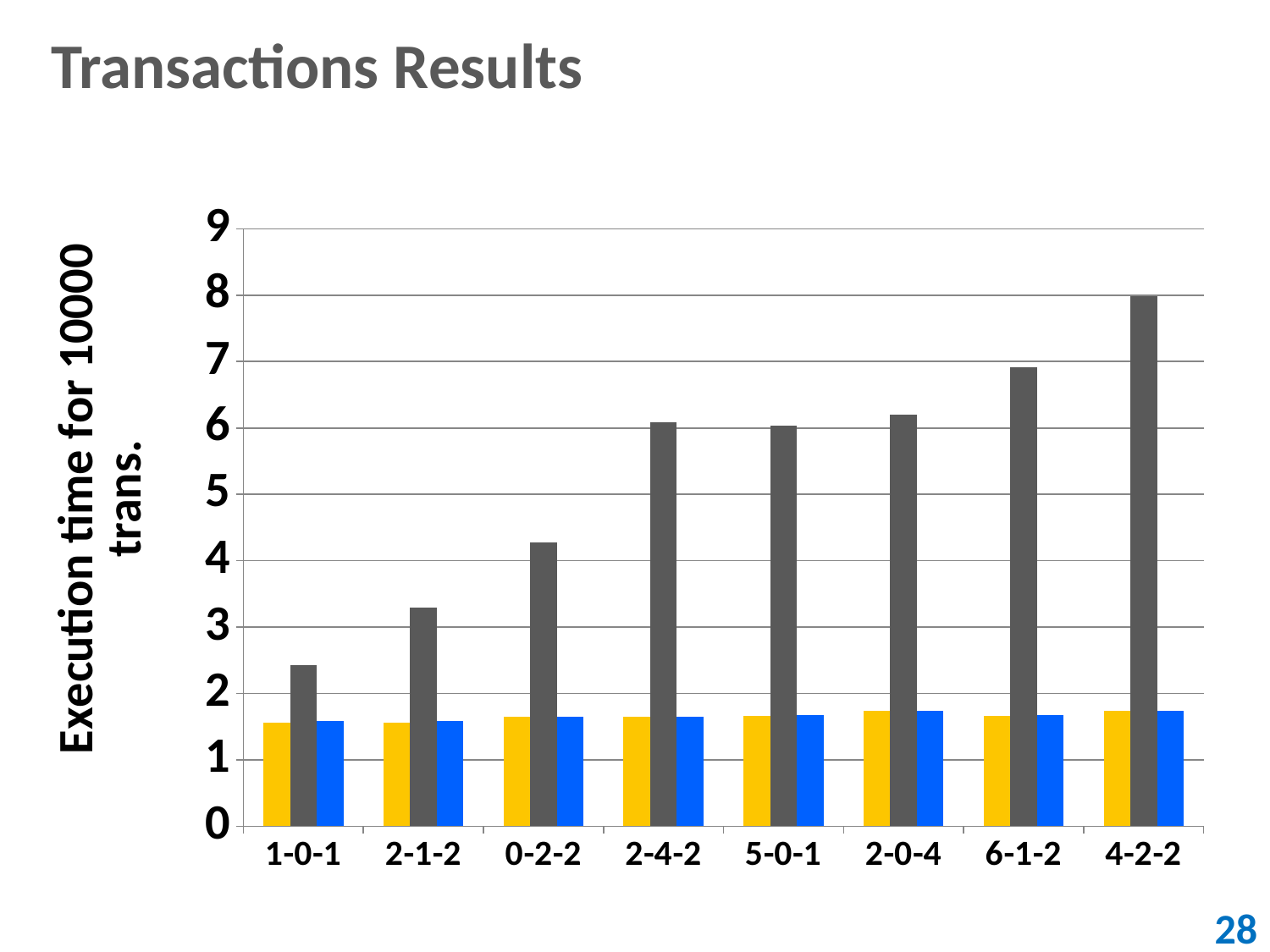
Is the dark gray bar for 1-0-1 greater or less than 3? less Is the dark gray bar for 4-2-2 greater or less than 7? greater Is the dark gray bar for 6-1-2 greater or less than 6? greater How many categories are shown along the x axis? 8 What kind of chart is shown on the slide? bar chart Which category has the tallest dark gray bar? 4-2-2 Which category has the shortest dark gray bar? 1-0-1 Which has the taller dark gray bar, 2-1-2 or 0-2-2? 0-2-2 What is the y-axis title of the chart? Execution time for 10000 trans. How many bars are plotted for each category? 3